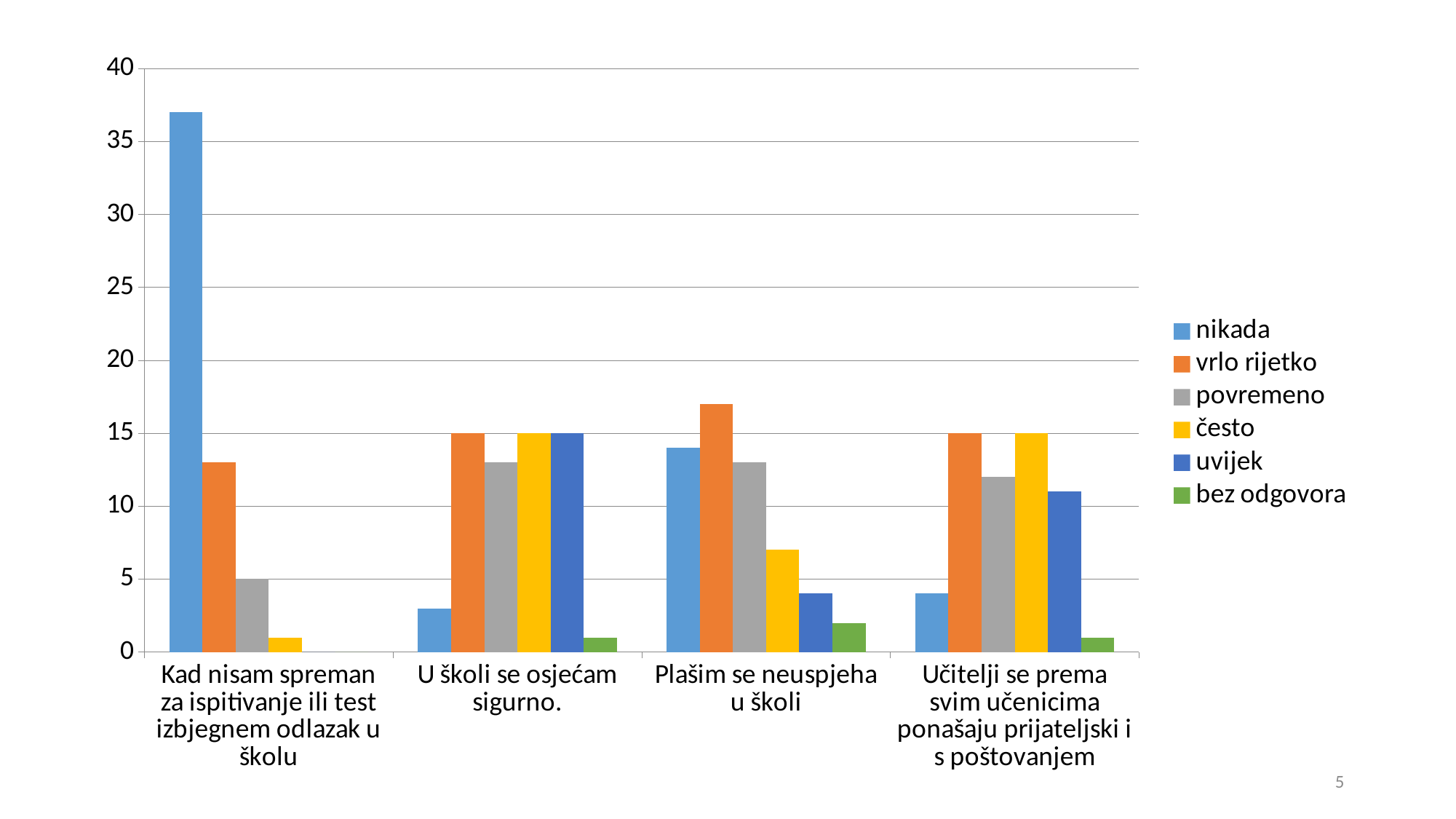
How many categories are shown on the x axis? 4 Which series has the highest value for "Kad nisam spreman za ispitivanje ili test izbjegnem odlazak u školu"? nikada What is the value of "često" for "Učitelji se prema svim učenicima ponašaju prijateljski i s poštovanjem"? 15 What is the value of "povremeno" for "Kad nisam spreman za ispitivanje ili test izbjegnem odlazak u školu"? 5 Which series has the highest value for "Plašim se neuspjeha u školi"? vrlo rijetko Is the value of "uvijek" for "Učitelji se prema svim učenicima ponašaju prijateljski i s poštovanjem" greater or less than 10? greater For "Plašim se neuspjeha u školi", which is larger: "često" or "uvijek"? često Which series has the lowest value for "U školi se osjećam sigurno."? bez odgovora How many series does the legend list? 6 Is the value of "nikada" for "Kad nisam spreman za ispitivanje ili test izbjegnem odlazak u školu" greater or less than 35? greater What kind of chart is shown on the slide? bar chart What is the value of "uvijek" for "U školi se osjećam sigurno."? 15